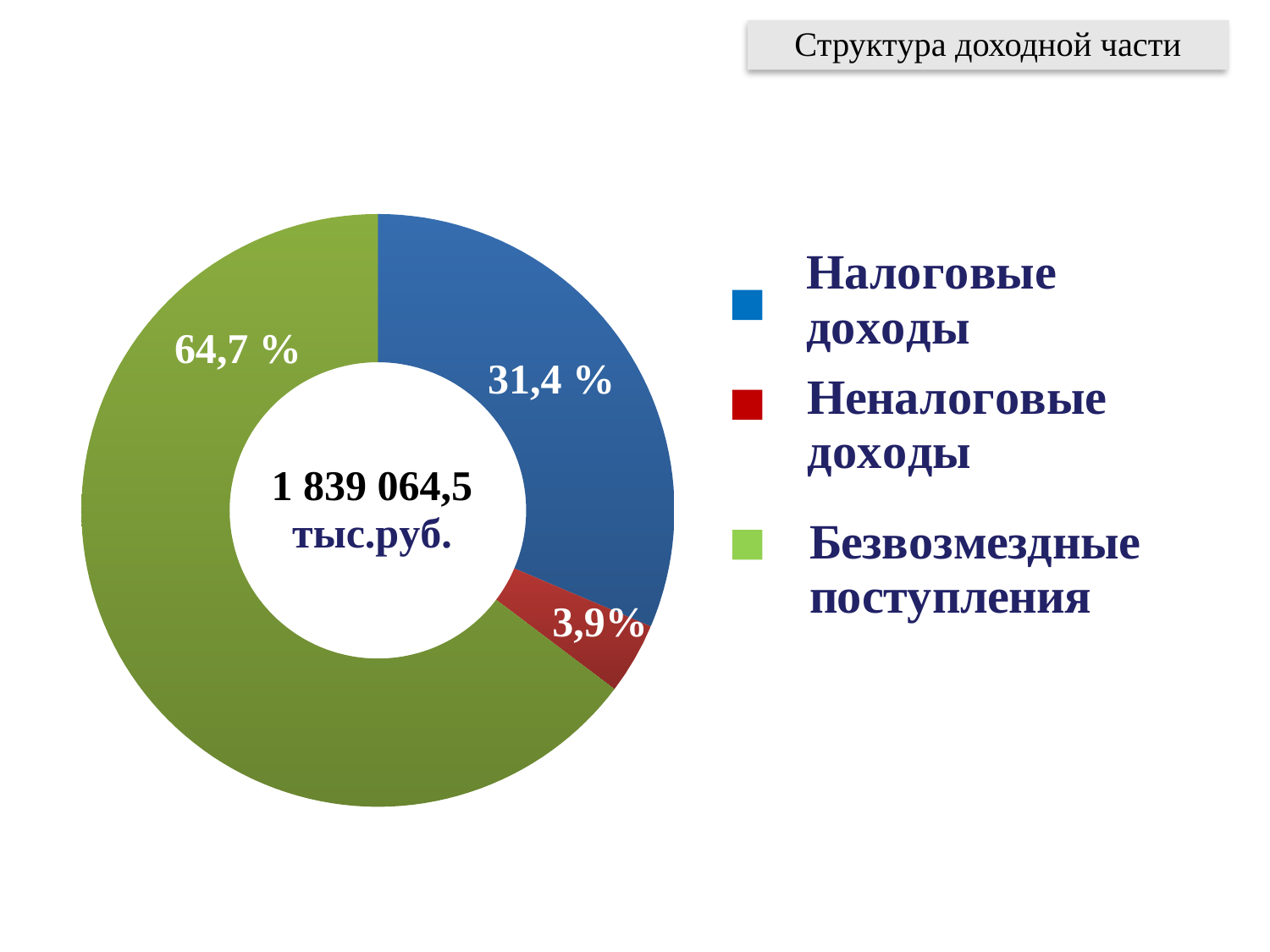
By how many percentage points does the share of Налоговые доходы exceed the share of Неналоговые доходы? 27,5 What share of the chart is labelled for Безвозмездные поступления? 64,7 % Which category has the largest share of the chart? Безвозмездные поступления What kind of chart is shown on the slide? Doughnut (pie) chart How many categories does the chart show? 3 Which is larger: the share for Налоговые доходы or the share for Неналоговые доходы? Налоговые доходы What colour represents Безвозмездные поступления in the chart? Green What total value is printed in the centre of the chart? 1 839 064,5 тыс.руб. Which category has the smallest share of the chart? Неналоговые доходы By how many percentage points does the share of Безвозмездные поступления exceed the share of Налоговые доходы? 33,3 What share of the chart is labelled for Неналоговые доходы? 3,9% What share of the chart is labelled for Налоговые доходы? 31,4 %